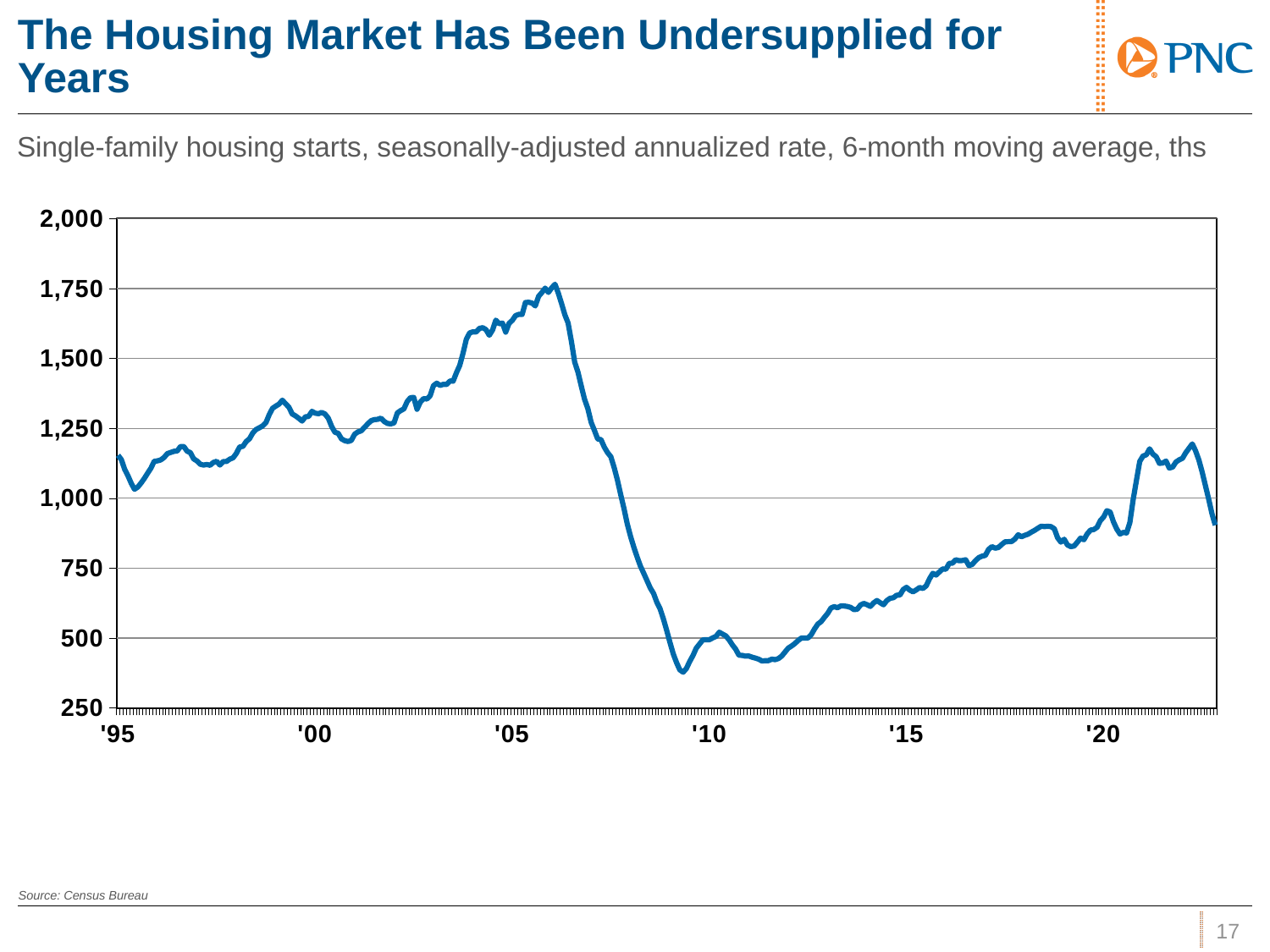
Is the value at '00 greater or less than 1,000? greater Is the value at the start of the line in '95 greater or less than 1,000? greater Is the value around '10 greater or less than 750? less Is the lowest point of the line before or after '05? after Does the line rise or fall between '05 and '10? fall What source is cited for the chart? Census Bureau Does the line rise or fall between '10 and '20? rise What is the subtitle describing the data plotted in the chart? Single-family housing starts, seasonally-adjusted annualized rate, 6-month moving average, ths What kind of chart is shown on the slide? line chart